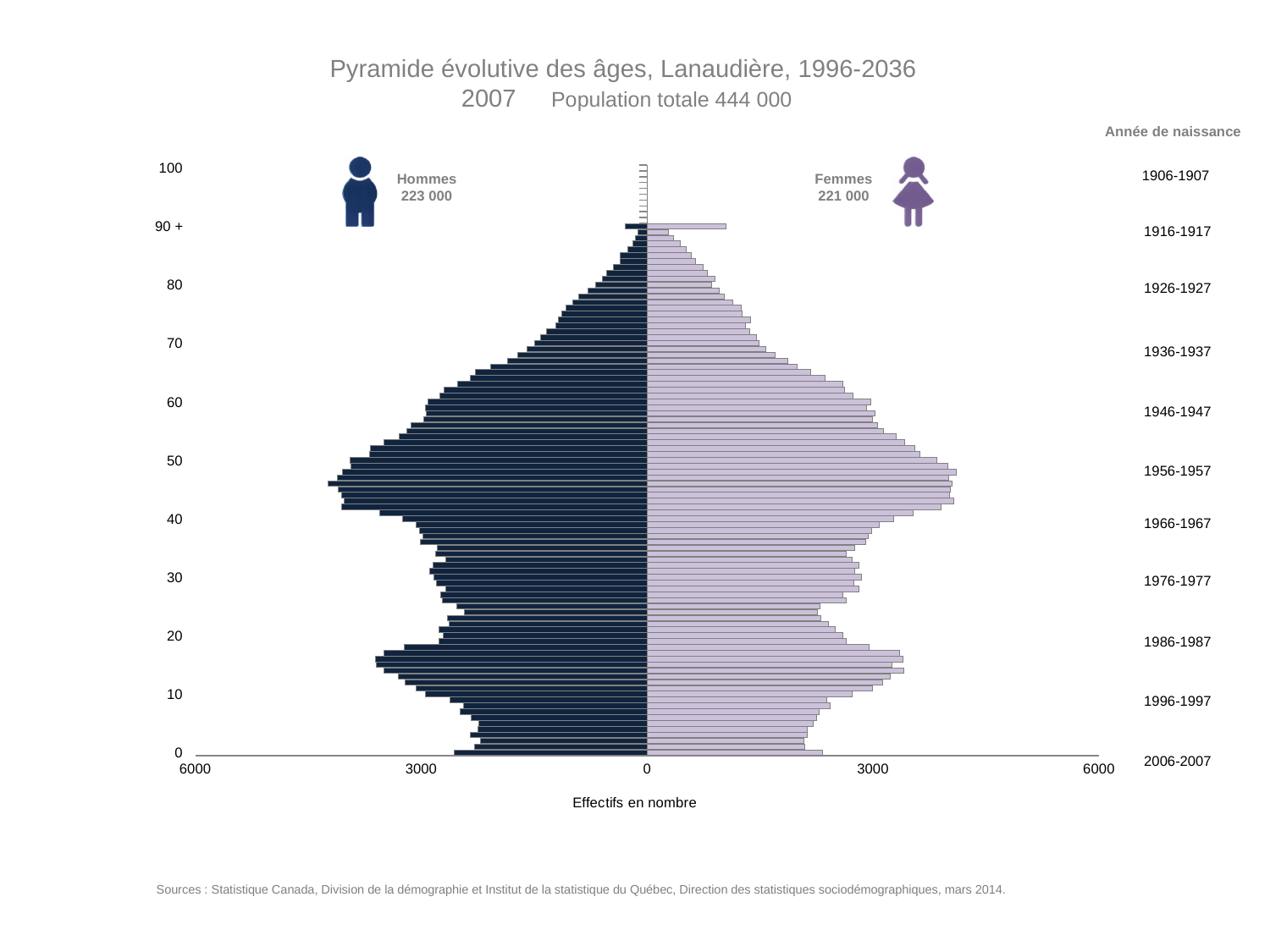
Is the number of men aged around 46 greater or less than 3000? greater What kind of chart is shown on the slide? Bar chart (population pyramid) What is the difference between the number of Hommes and the number of Femmes? 2 000 Do the bar lengths rise or fall as age increases from 50 to 90+? fall Is the number of women aged around 80 greater or less than 3000? less What is the total number of Femmes (women) shown on the chart? 221 000 Is the number of men aged 0 greater or less than 3000? less What is the label of the horizontal axis? Effectifs en nombre What is the total number of Hommes (men) shown on the chart? 223 000 Which group is larger, Hommes or Femmes? Hommes What year does this pyramid represent? 2007 What is the total population shown in the chart subtitle? 444 000